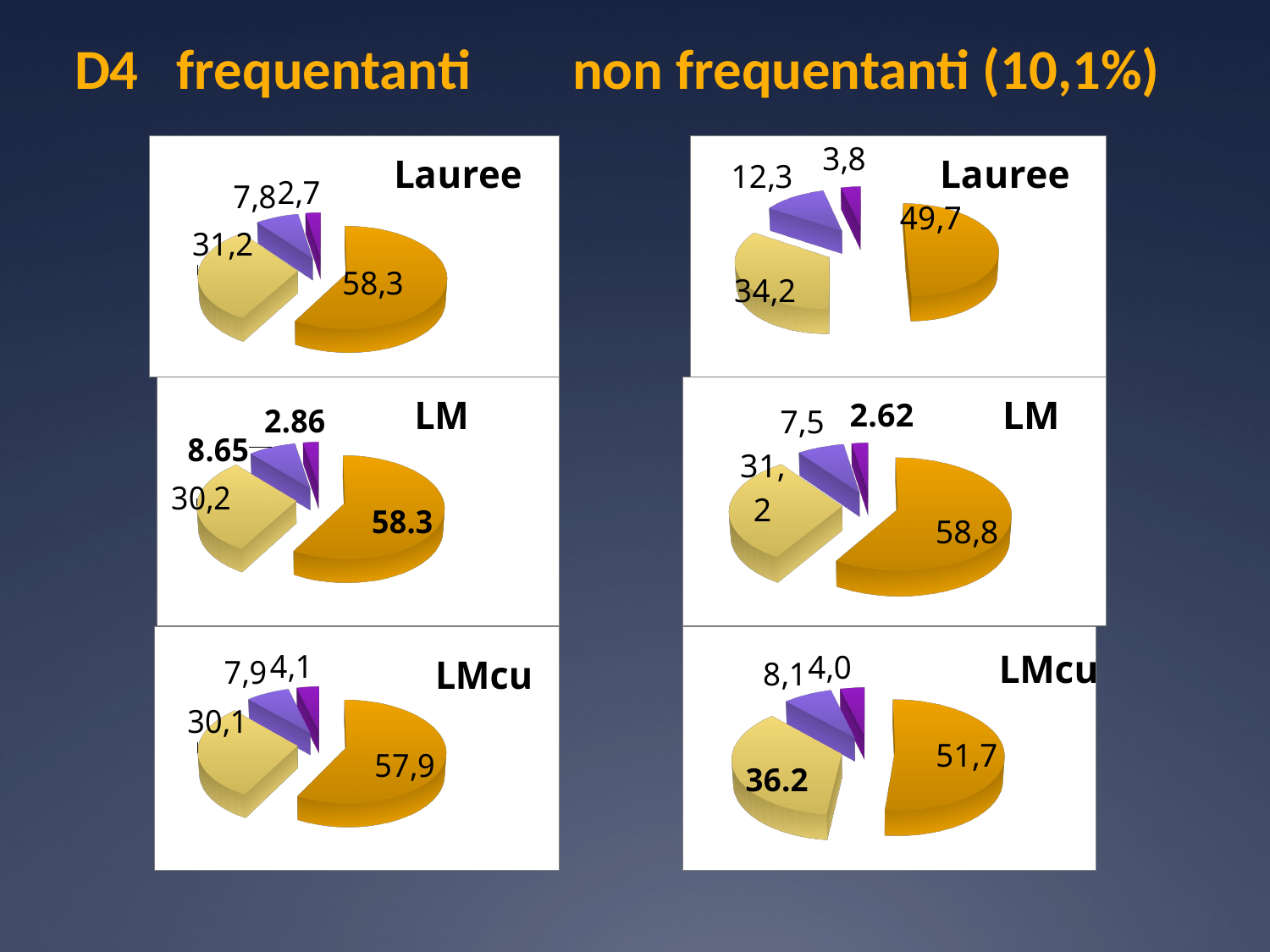
Which is larger: the orange slice in the top-left 'Lauree' chart (frequentanti) or the orange slice in the top-right 'Lauree' chart (non frequentanti)? Top-left (frequentanti), 58,3 In the bottom-left 'LMcu' pie chart (frequentanti), what is the value of the orange slice? 57,9 In the top-right 'Lauree' pie chart (non frequentanti), what is the value of the largest orange slice? 49,7 In the middle-left 'LM' pie chart (frequentanti), what is the value of the yellow slice? 30,2 In the bottom-right 'LMcu' pie chart (non frequentanti), what is the value of the yellow slice? 36.2 How many pie charts are on the slide? 6 How many slices does the bottom-right 'LMcu' pie chart (non frequentanti) have? 4 What kind of charts are shown on the slide? Pie charts In the top-left 'Lauree' pie chart (frequentanti), what is the value of the largest orange slice? 58,3 In the middle-right 'LM' pie chart (non frequentanti), what is the largest value shown? 58,8 What is the difference between the orange slice values of the bottom-left 'LMcu' chart (57,9) and the bottom-right 'LMcu' chart (51,7)? 6,2 In the top-right 'Lauree' pie chart (non frequentanti), what is the smallest value shown? 3,8